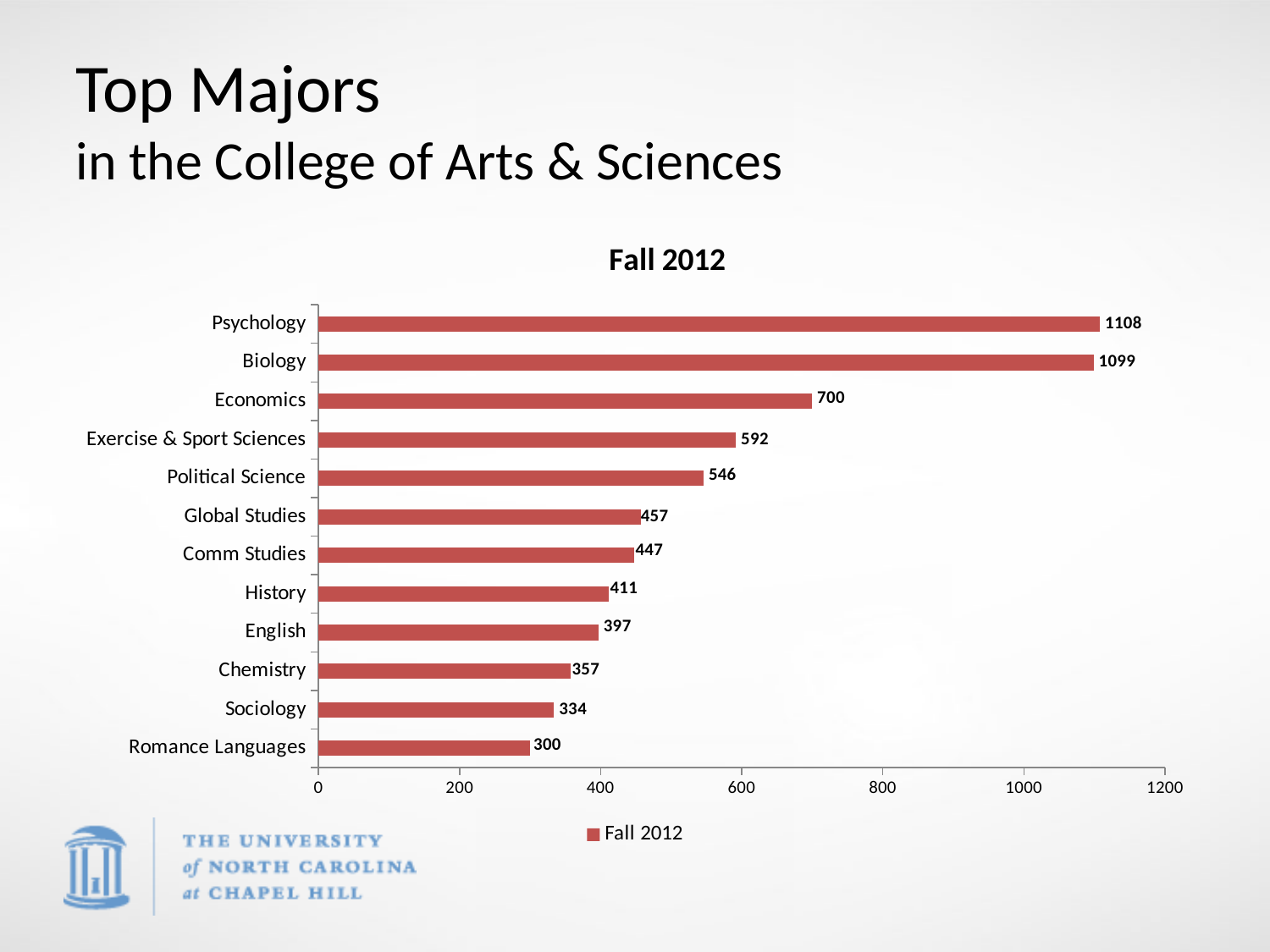
How many series does the legend list? 1 What is the value for Chemistry? 357 What kind of chart is shown on the slide? Bar chart What is the value for Exercise & Sport Sciences? 592 What is the difference between the values for Economics and Political Science? 154 Which has a larger value, History or Sociology? History How many majors are shown in the chart? 12 Which major has the highest value? Psychology Which major has the lowest value? Romance Languages Is the value for Global Studies greater or less than 400? greater What is the difference between the values for Psychology and Biology? 9 What is the value for Psychology? 1108